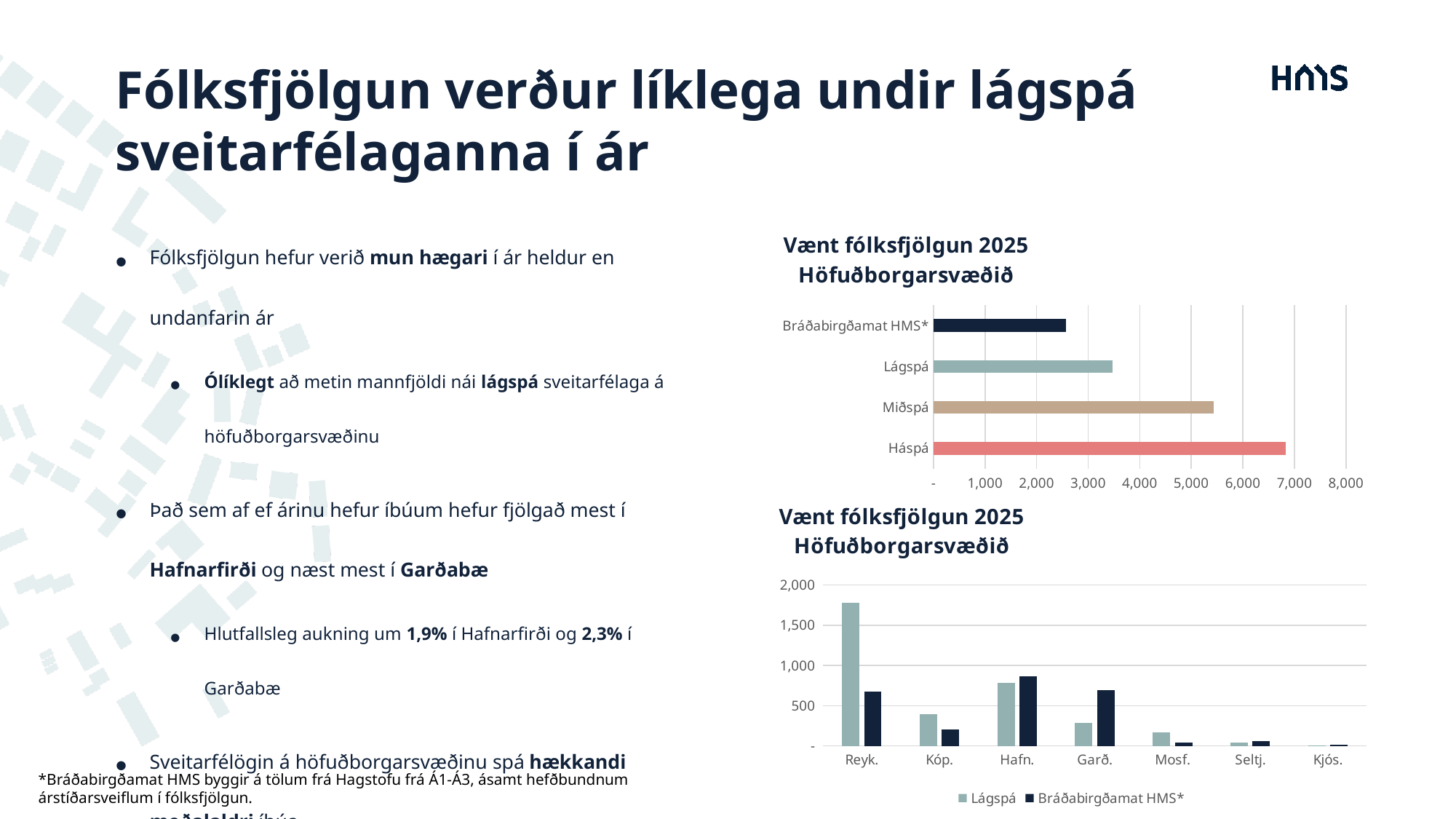
In the bottom chart, which is larger for Garð., Lágspá or Bráðabirgðamat HMS*? Bráðabirgðamat HMS* How many categories does the top chart show? 4 In the top chart, which category has the lowest value? Bráðabirgðamat HMS* In the bottom chart, is the Lágspá value for Reyk. greater or less than 1,500? greater In the bottom chart, which municipality has the highest Lágspá value? Reyk. How many series does the legend of the bottom chart list? 2 In the top chart, which is larger, Miðspá or Lágspá? Miðspá How many municipalities are shown on the x axis of the bottom chart? 7 What kind of chart is the top chart on the slide? bar chart In the top chart, is the value for Háspá greater or less than 6,000? greater In the top chart, is the value for Bráðabirgðamat HMS* greater or less than 3,000? less In the top chart, which category has the highest value? Háspá